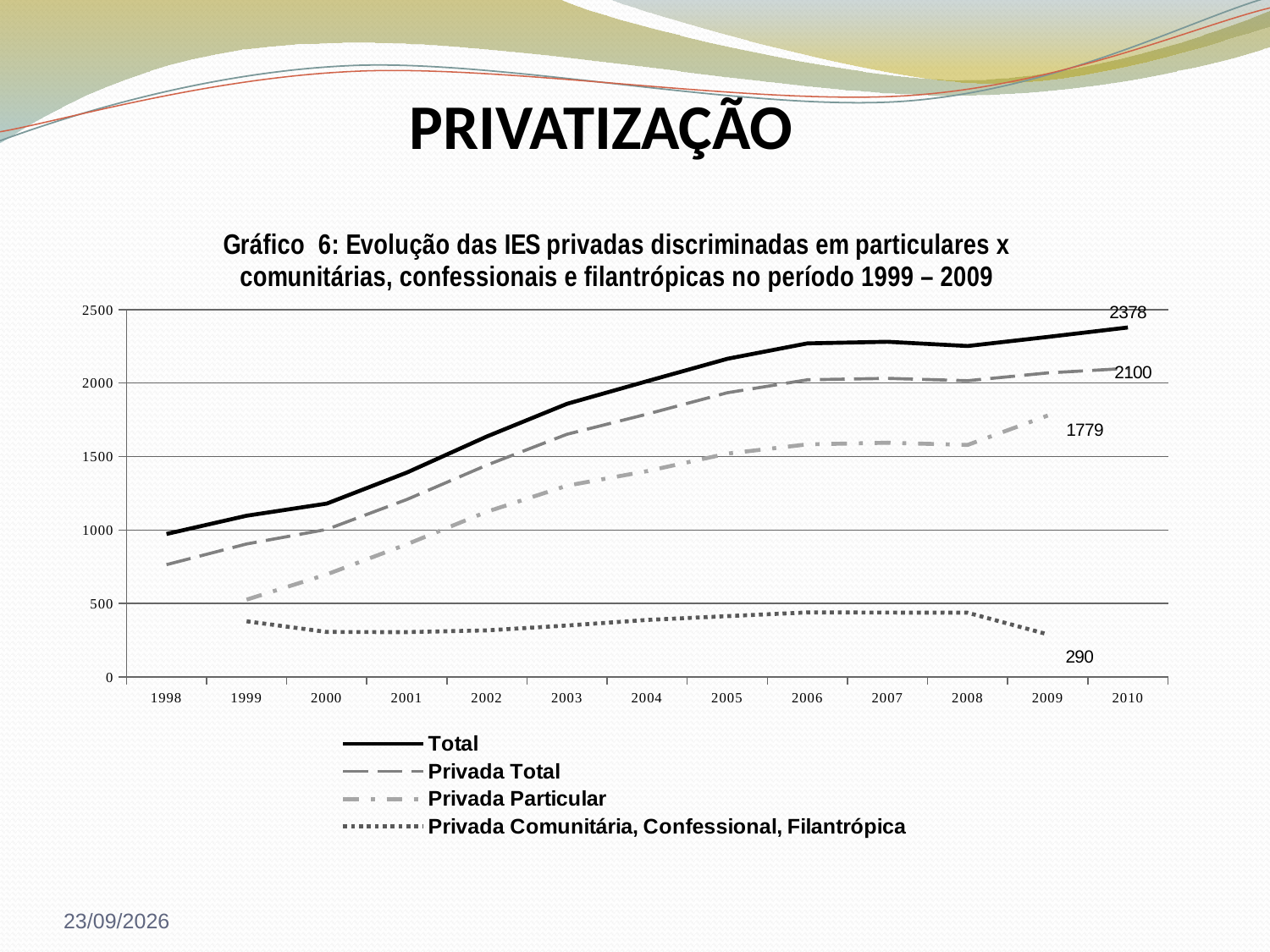
How many years are shown on the x axis? 13 Is the value for Privada Comunitária, Confessional, Filantrópica in 2006 greater or less than 500? less What is the value of the Privada Total series in 2010? 2100 Does the Total series generally rise or fall from 1998 to 2010? rise What type of chart is shown on the slide? line chart What is the value of the Total series in 2010? 2378 What is the value of the Privada Particular series in 2009? 1779 How many series does the legend list? 4 What is the value of the Privada Comunitária, Confessional, Filantrópica series in 2009? 290 Is the value for Total in 1998 greater or less than 500? greater Which series has the lowest values across the chart? Privada Comunitária, Confessional, Filantrópica What is the difference between the Total value in 2010 and the Privada Total value in 2010? 278